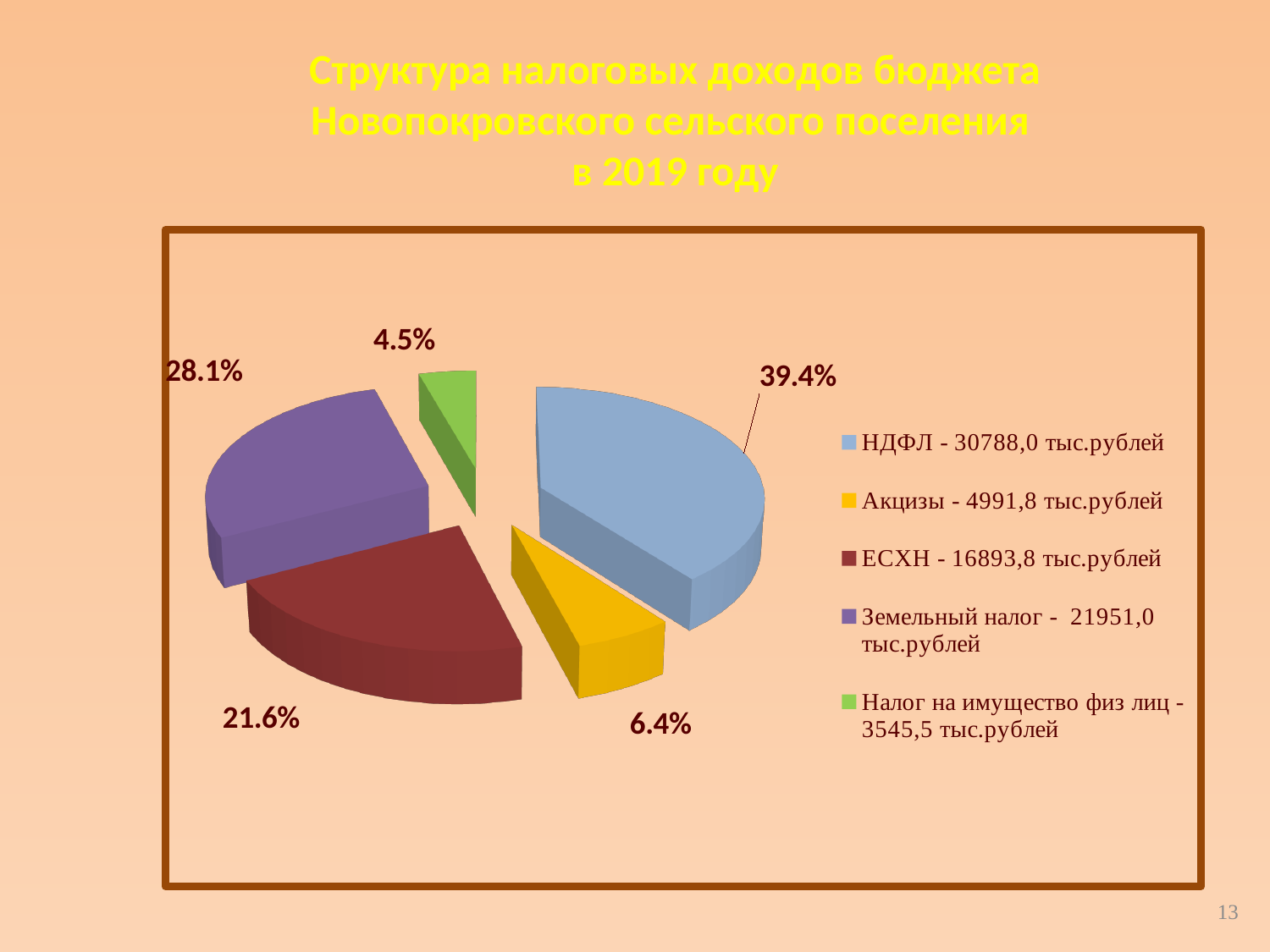
What kind of chart is shown on the slide? pie chart What share of the pie does Земельный налог account for? 28.1% What share of the pie does НДФЛ account for? 39.4% What share of the pie does ЕСХН account for? 21.6% What is the difference in percentage points between the НДФЛ slice and the Земельный налог slice? 11.3 Which category has the smallest slice of the pie? Налог на имущество физ лиц What amount in тыс.рублей does the legend give for Акцизы? 4991,8 тыс.рублей How many slices does the pie chart have? 5 Which slice is larger, ЕСХН or Акцизы? ЕСХН Which category has the largest slice of the pie? НДФЛ